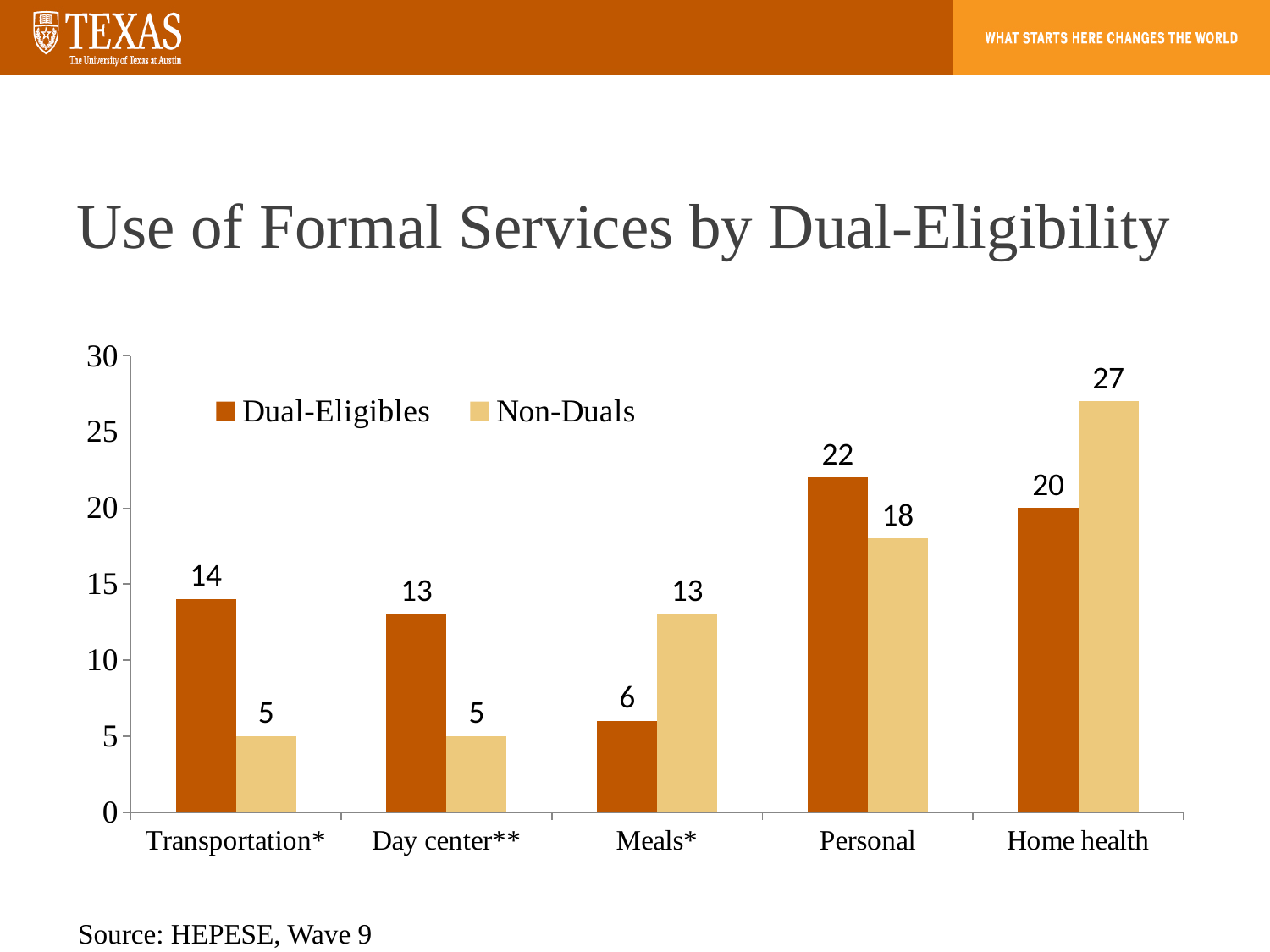
What is the difference between the Dual-Eligibles and Non-Duals values in the Transportation* category? 9 What kind of chart is shown on the slide? Bar chart What is the value for Non-Duals in the Home health category? 27 What is the value for Non-Duals in the Meals* category? 13 How many categories are shown on the x axis? 5 Which category has the highest value for Dual-Eligibles? Personal Which category has the highest value for Non-Duals? Home health What is the title of the chart on the slide? Use of Formal Services by Dual-Eligibility In the Personal category, which series has the larger value, Dual-Eligibles or Non-Duals? Dual-Eligibles How many series does the legend list? 2 Which category has the lowest value for Dual-Eligibles? Meals* What is the value for Dual-Eligibles in the Transportation* category? 14